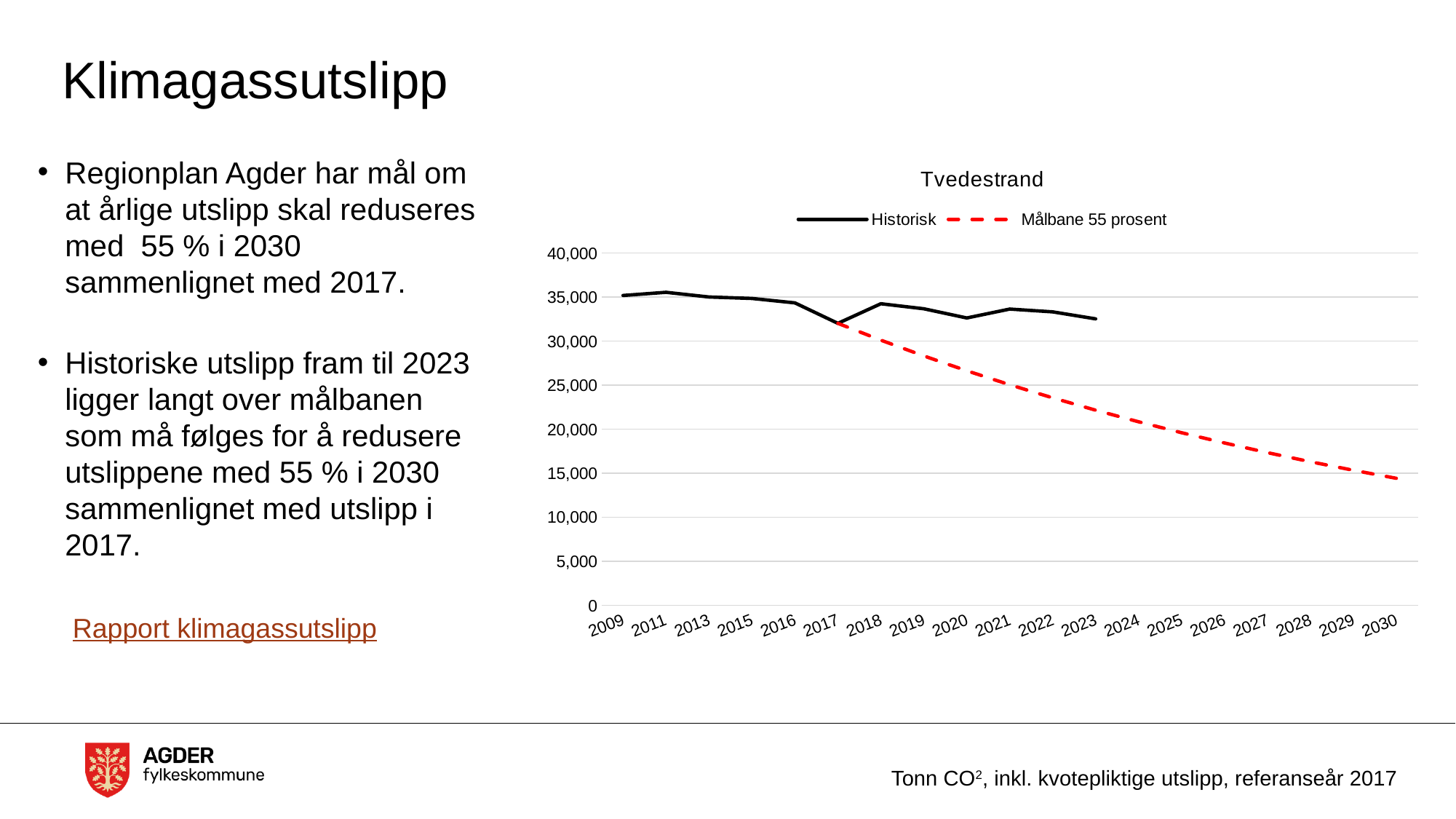
Is the Historisk value for 2023 greater or less than 30,000? greater Does the Målbane 55 prosent series rise or fall from 2017 to 2030? fall How many series does the legend of the Tvedestrand chart list? 2 How many years are labelled on the x axis of the chart? 19 Which is larger, the Historisk value for 2017 or for 2018? 2018 Is the Målbane 55 prosent value for 2020 greater or less than 25,000? greater Which is larger, the Historisk value for 2011 or for 2023? 2011 What is the title of the chart? Tvedestrand What are the names of the two series in the legend of the chart? Historisk and Målbane 55 prosent Is the Historisk value for 2017 greater or less than 35,000? less What kind of chart is shown on the slide? line chart